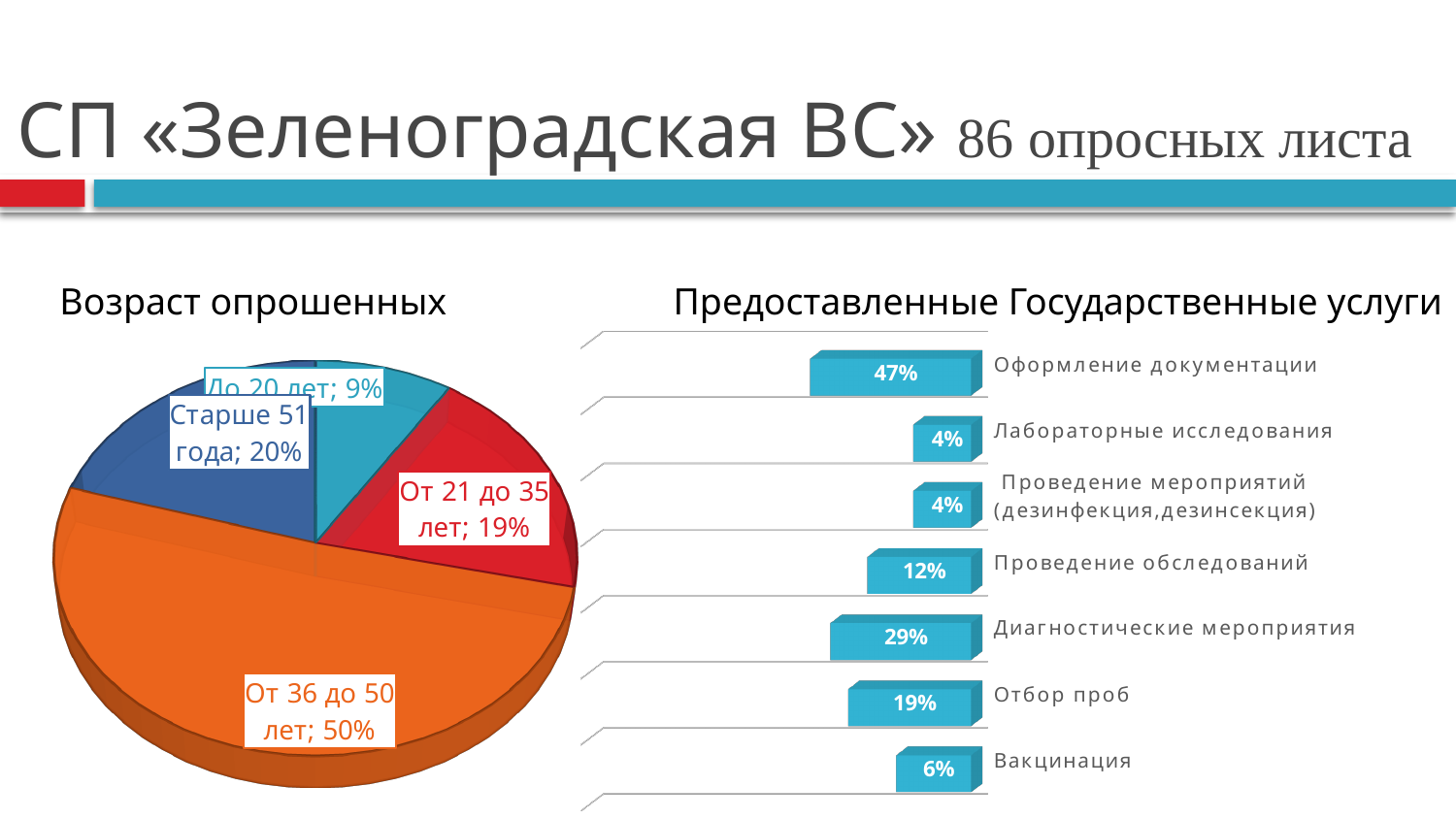
In the pie chart "Возраст опрошенных", how many age groups are shown? 4 In the pie chart "Возраст опрошенных", which age group has the smallest share? До 20 лет In the chart "Предоставленные Государственные услуги", what is the value for "Оформление документации"? 47% In the pie chart "Возраст опрошенных", what share of respondents are "От 36 до 50 лет"? 50% In the chart "Предоставленные Государственные услуги", how many services are listed? 7 In the pie chart "Возраст опрошенных", what is the difference between the shares of "Старше 51 года" and "От 21 до 35 лет"? 1% In the pie chart "Возраст опрошенных", what share of respondents are "До 20 лет"? 9% In the chart "Предоставленные Государственные услуги", which service has the highest value? Оформление документации In the chart "Предоставленные Государственные услуги", what is the difference between "Отбор проб" and "Вакцинация"? 13% In the chart "Предоставленные Государственные услуги", what is the value for "Диагностические мероприятия"? 29% In the pie chart "Возраст опрошенных", which age group has the largest share? От 36 до 50 лет What type of chart is "Предоставленные Государственные услуги"? Bar chart